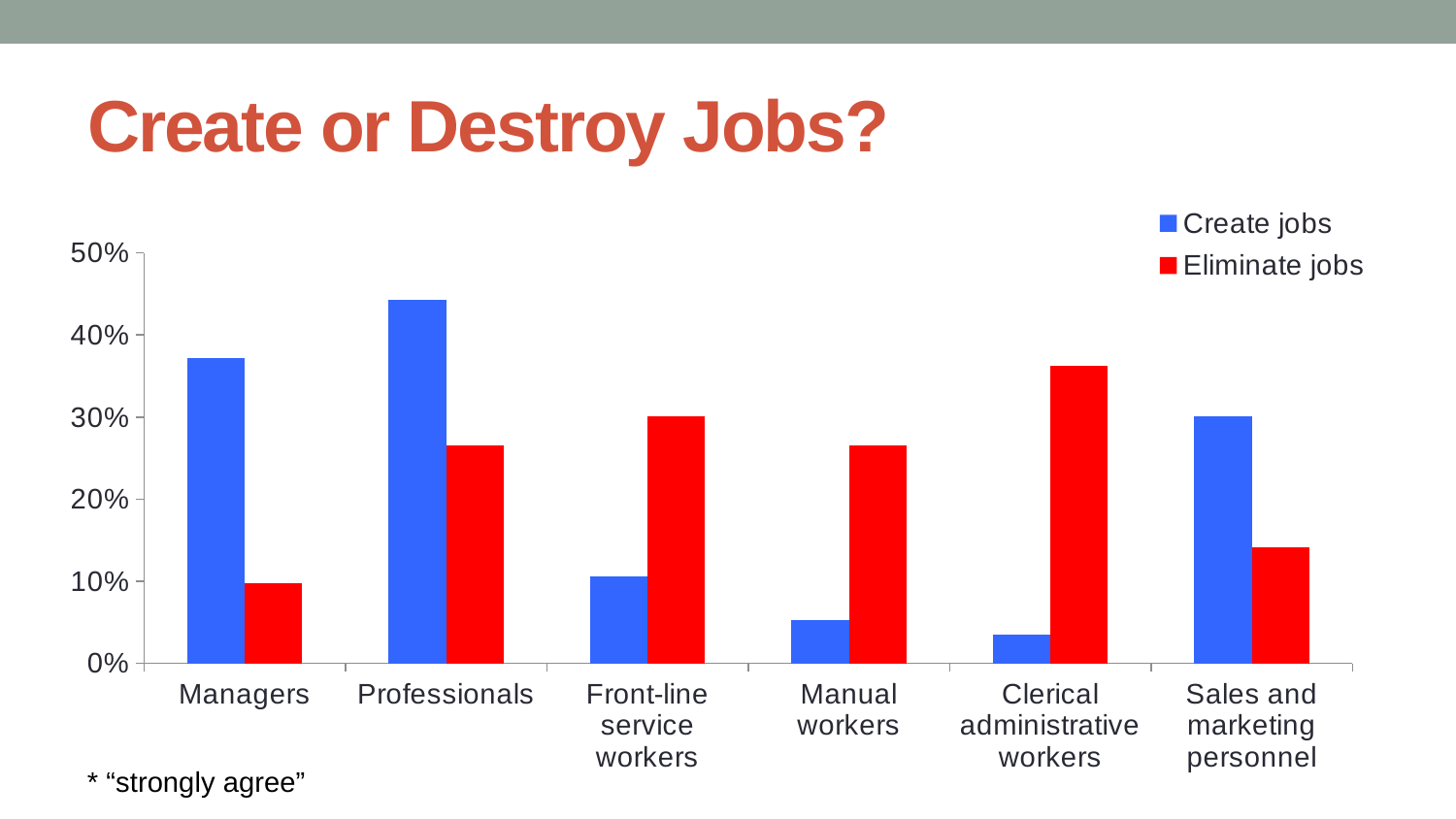
Is the Eliminate jobs value for Clerical administrative workers greater or less than 30%? greater For Front-line service workers, which is larger: Create jobs or Eliminate jobs? Eliminate jobs How many occupational categories are shown on the x axis? 6 How many series does the legend list? 2 Is the Create jobs value for Manual workers greater or less than 10%? less What kind of chart is shown on the slide? bar chart Is the Create jobs value for Professionals greater or less than 40%? greater Which category has the highest value for Create jobs? Professionals Which category has the lowest value for Eliminate jobs? Managers Which colour represents the Eliminate jobs series? red Which category has the highest value for Eliminate jobs? Clerical administrative workers